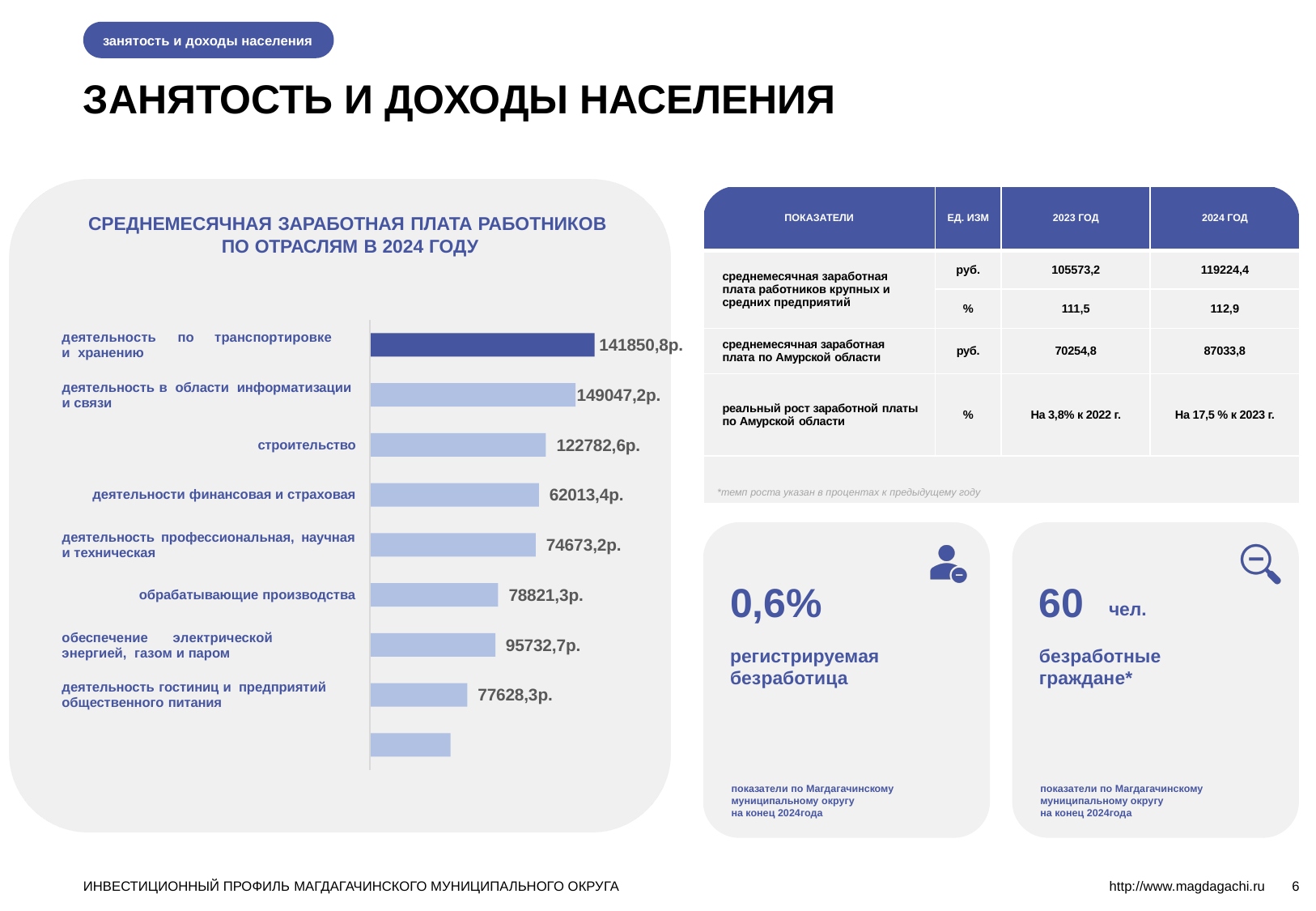
What is the average monthly salary shown for 'деятельность по транспортировке и хранению'? 141850,8р. What is the difference between the values for 'обеспечение электрической энергией, газом и паром' and 'деятельность профессиональная, научная и техническая'? 21059,5р. What value is labelled for 'обрабатывающие производства'? 78821,3р. What is the title of the chart on the left of the slide? СРЕДНЕМЕСЯЧНАЯ ЗАРАБОТНАЯ ПЛАТА РАБОТНИКОВ ПО ОТРАСЛЯМ В 2024 ГОДУ Which has the larger value: 'строительство' or 'обрабатывающие производства'? строительство What value is shown for 'строительство' in the bar chart? 122782,6р. What value is shown for 'деятельность гостиниц и предприятий общественного питания'? 77628,3р. What is the value for 'деятельности финансовая и страховая'? 62013,4р. What kind of chart is used to show average monthly salaries by industry? bar chart What is the value for 'обеспечение электрической энергией, газом и паром'? 95732,7р. What is the difference between the values for 'строительство' and 'деятельности финансовая и страховая'? 60769,2р. Which has the larger value: 'обеспечение электрической энергией, газом и паром' or 'деятельность гостиниц и предприятий общественного питания'? обеспечение электрической энергией, газом и паром